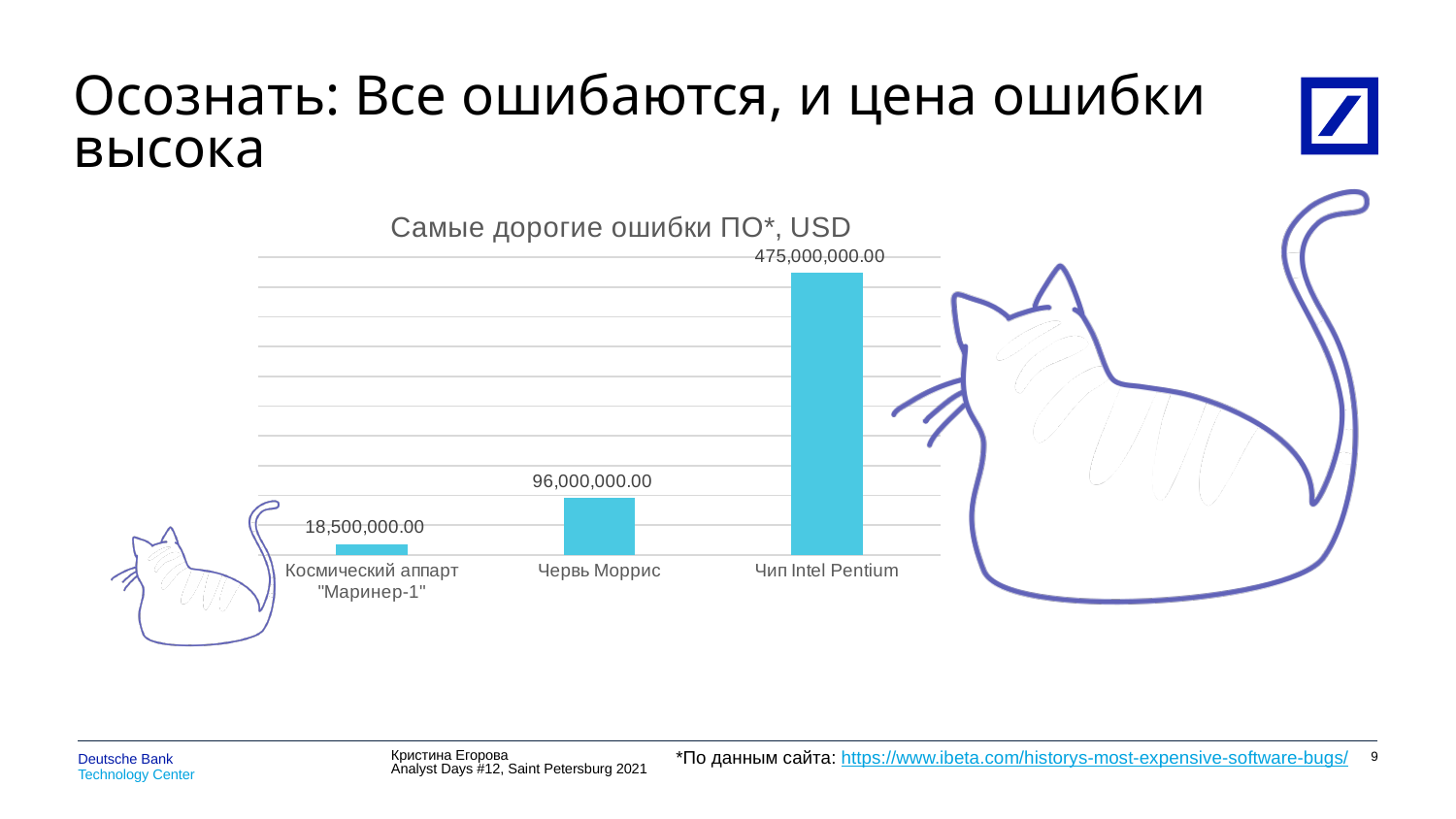
What is the title of the chart? Самые дорогие ошибки ПО*, USD Do the values rise or fall from left to right along the x axis? Rise Which category has the lowest value? Космический аппарт "Маринер-1" What is the difference between the values for Чип Intel Pentium and Червь Моррис? 379,000,000.00 Which category has the highest value? Чип Intel Pentium What is the value for Космический аппарт "Маринер-1"? 18,500,000.00 What is the value for Чип Intel Pentium? 475,000,000.00 What is the value for Червь Моррис? 96,000,000.00 How many categories are shown in the chart? 3 What kind of chart is shown on the slide? Bar chart What is the difference between the values for Червь Моррис and Космический аппарт "Маринер-1"? 77,500,000.00 Which is larger, the value for Червь Моррис or the value for Космический аппарт "Маринер-1"? Червь Моррис